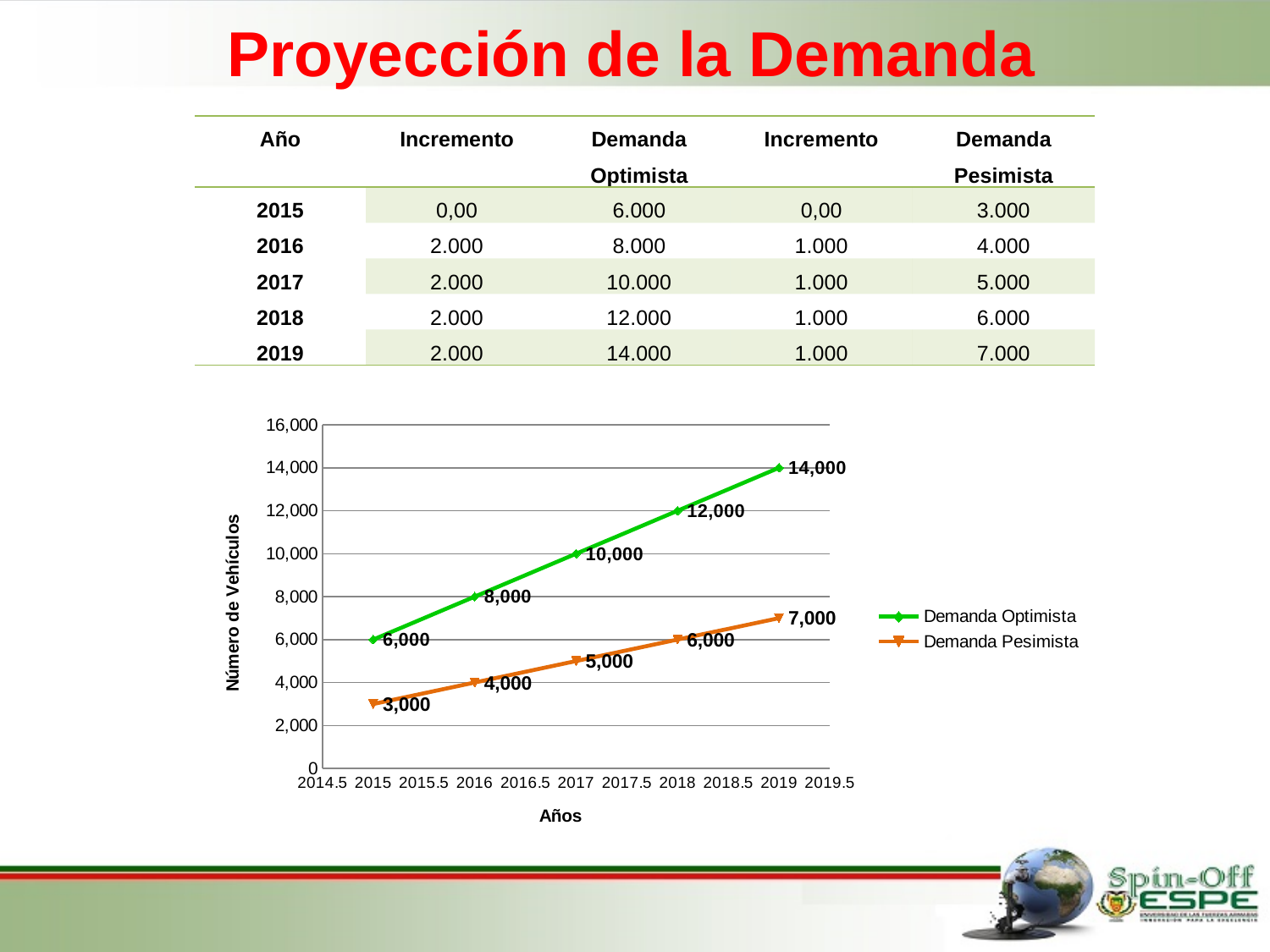
What is the value of Demanda Optimista in 2017? 10,000 What kind of chart is shown on the slide? Line chart What is the value of Demanda Optimista in 2019? 14,000 What is the difference between Demanda Optimista and Demanda Pesimista in 2019? 7,000 Does Demanda Pesimista rise or fall from 2015 to 2019? Rise How many series does the legend list? 2 How many data points does the Demanda Optimista series have? 5 Which is larger in 2016: Demanda Optimista or Demanda Pesimista? Demanda Optimista What is the value of Demanda Pesimista in 2015? 3,000 What is the value of Demanda Pesimista in 2018? 6,000 In which year is Demanda Optimista highest? 2019 In which year is Demanda Pesimista lowest? 2015